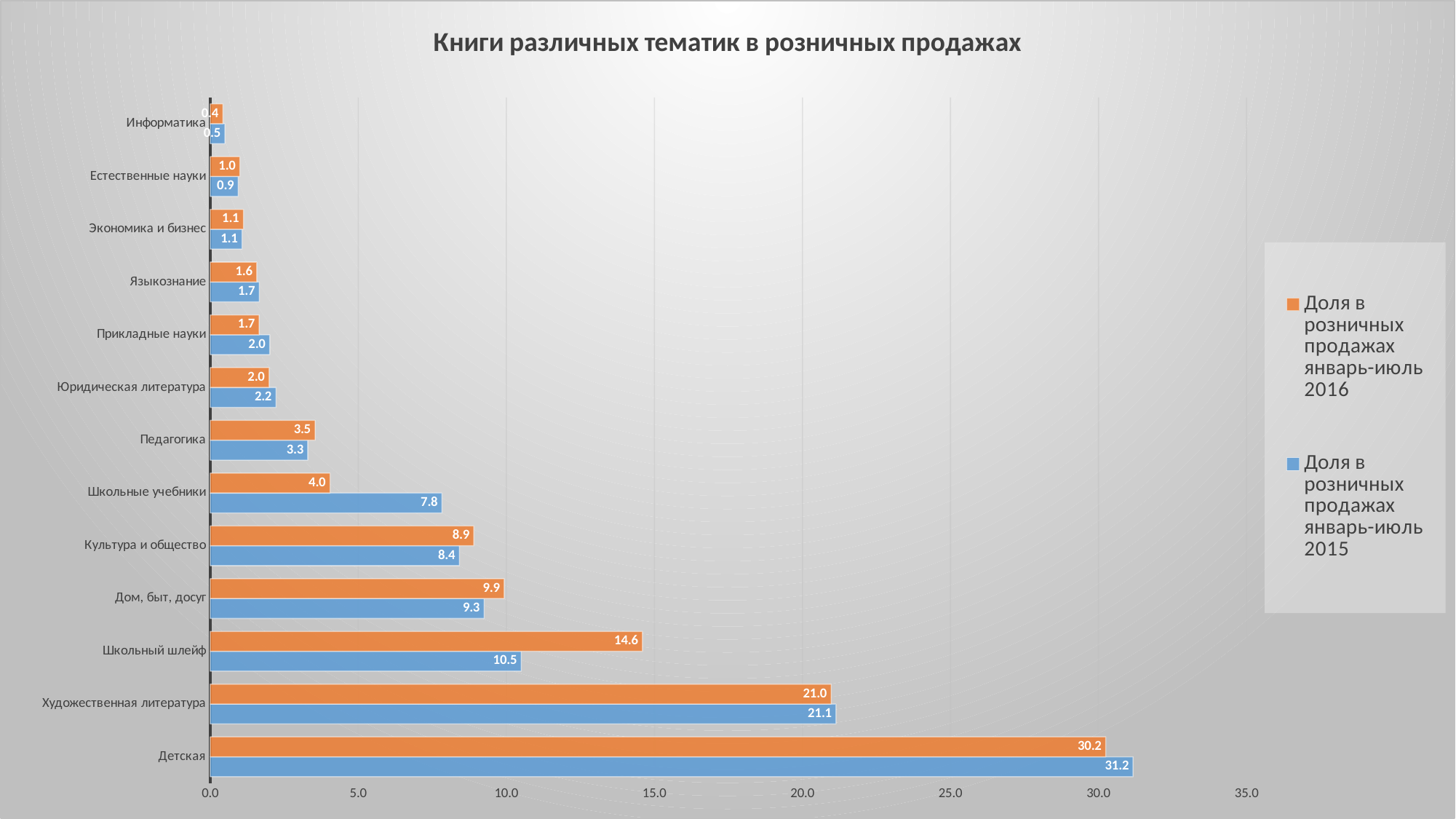
For Школьные учебники, which series has the larger value: январь-июль 2016 or январь-июль 2015? январь-июль 2015 What is the title of the chart? Книги различных тематик в розничных продажах Which category has the highest value in the series Доля в розничных продажах январь-июль 2015? Детская How many series does the legend list? 2 What kind of chart is shown on the slide? Bar chart What is the value for Школьные учебники in the series Доля в розничных продажах январь-июль 2015? 7.8 Is the value for Художественная литература in the 2016 series greater or less than 20.0? greater How many categories are shown on the chart? 13 Which category has the lowest value in the series Доля в розничных продажах январь-июль 2016? Информатика What is the value for Детская in the series Доля в розничных продажах январь-июль 2016? 30.2 What is the value for Школьный шлейф in the series Доля в розничных продажах январь-июль 2016? 14.6 What is the difference between the 2016 and 2015 values for Школьный шлейф? 4.1